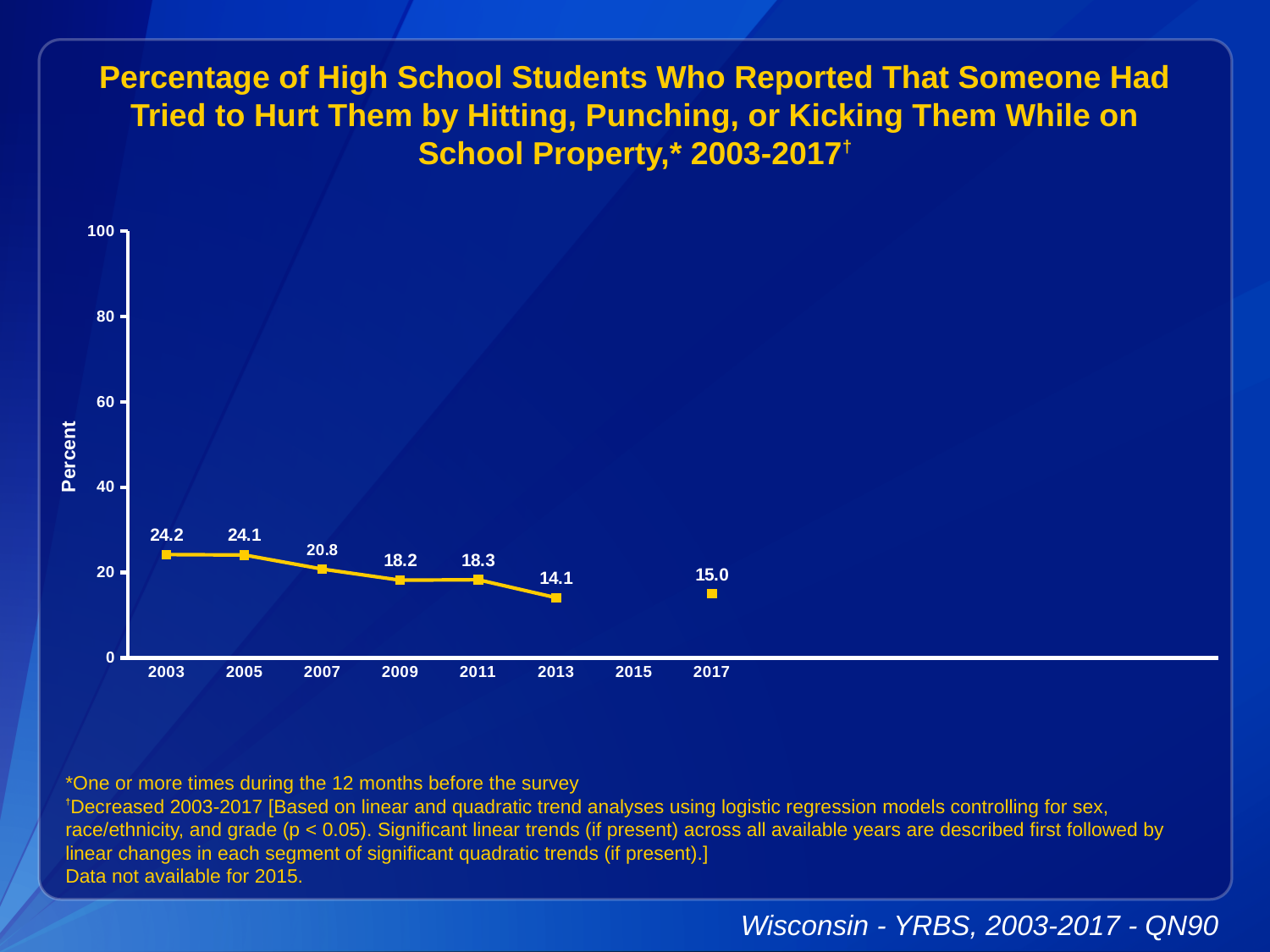
How many years have a data point plotted on the chart? 7 What is the label on the y axis? Percent What is the difference between the 2003 value and the 2017 value? 9.2 What percentage of high school students reported being hit, punched, or kicked on school property in 2003? 24.2 Which year has a larger value, 2007 or 2011? 2007 Is the value for 2005 greater or less than 20? greater What is the value plotted for 2009? 18.2 Which year has the highest value on the chart? 2003 What kind of chart is shown on the slide? line chart Do the values generally rise or fall from 2003 to 2013? fall What is the value plotted for 2017? 15.0 Which year has the lowest value on the chart? 2013